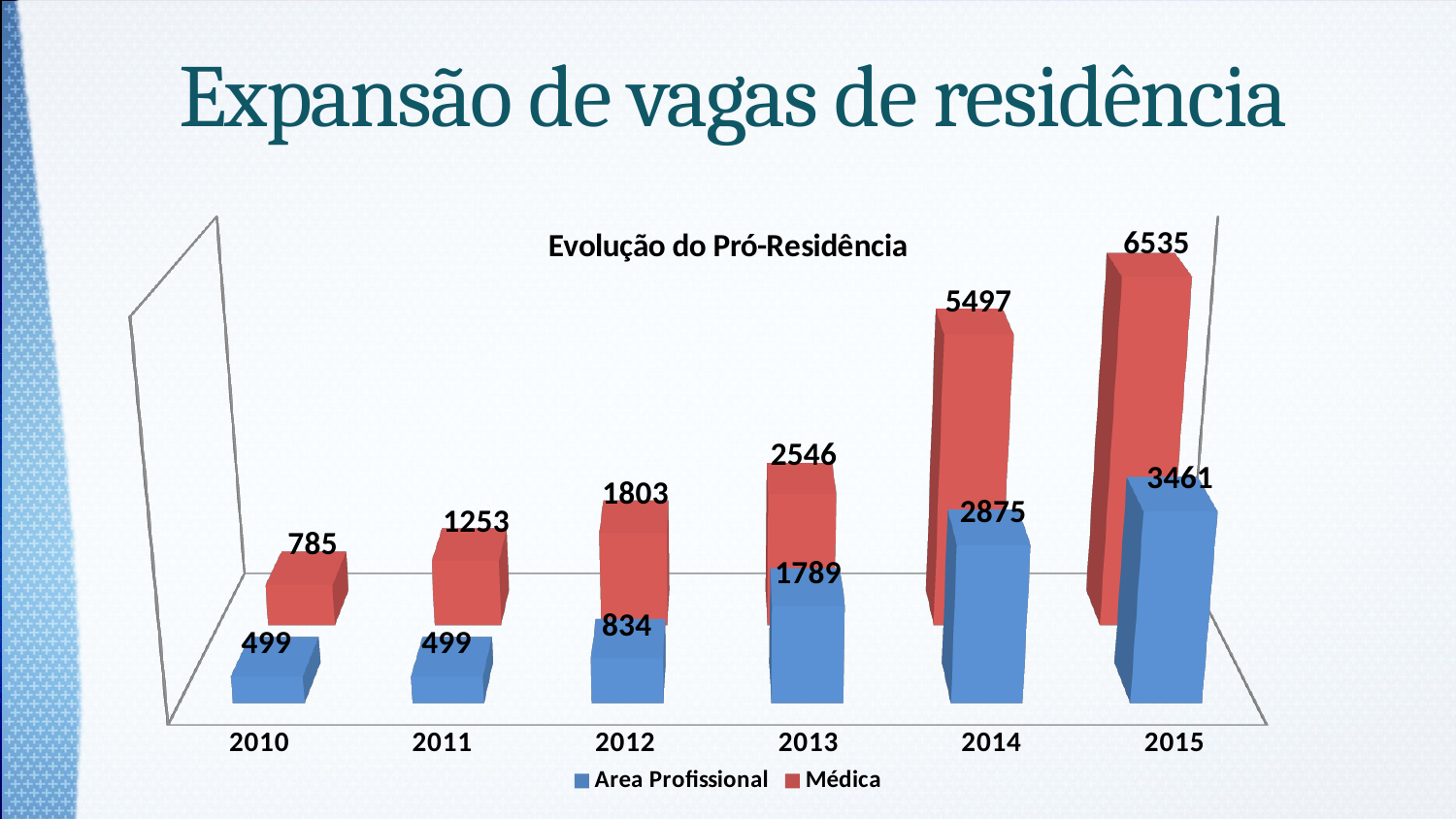
What kind of chart is shown? Bar chart What is the value for Médica in 2011? 1253 Which is larger in 2012, Area Profissional or Médica? Médica In which year is the Médica value lowest? 2010 How many series does the legend list? 2 What is the difference between the Médica and Area Profissional values in 2014? 2622 How many years are shown on the x axis? 6 What is the title of the chart? Evolução do Pró-Residência What is the value for Médica in 2015? 6535 In which year is the Area Profissional value highest? 2015 What is the value for Area Profissional in 2013? 1789 Do the Médica values rise or fall from 2010 to 2015? Rise